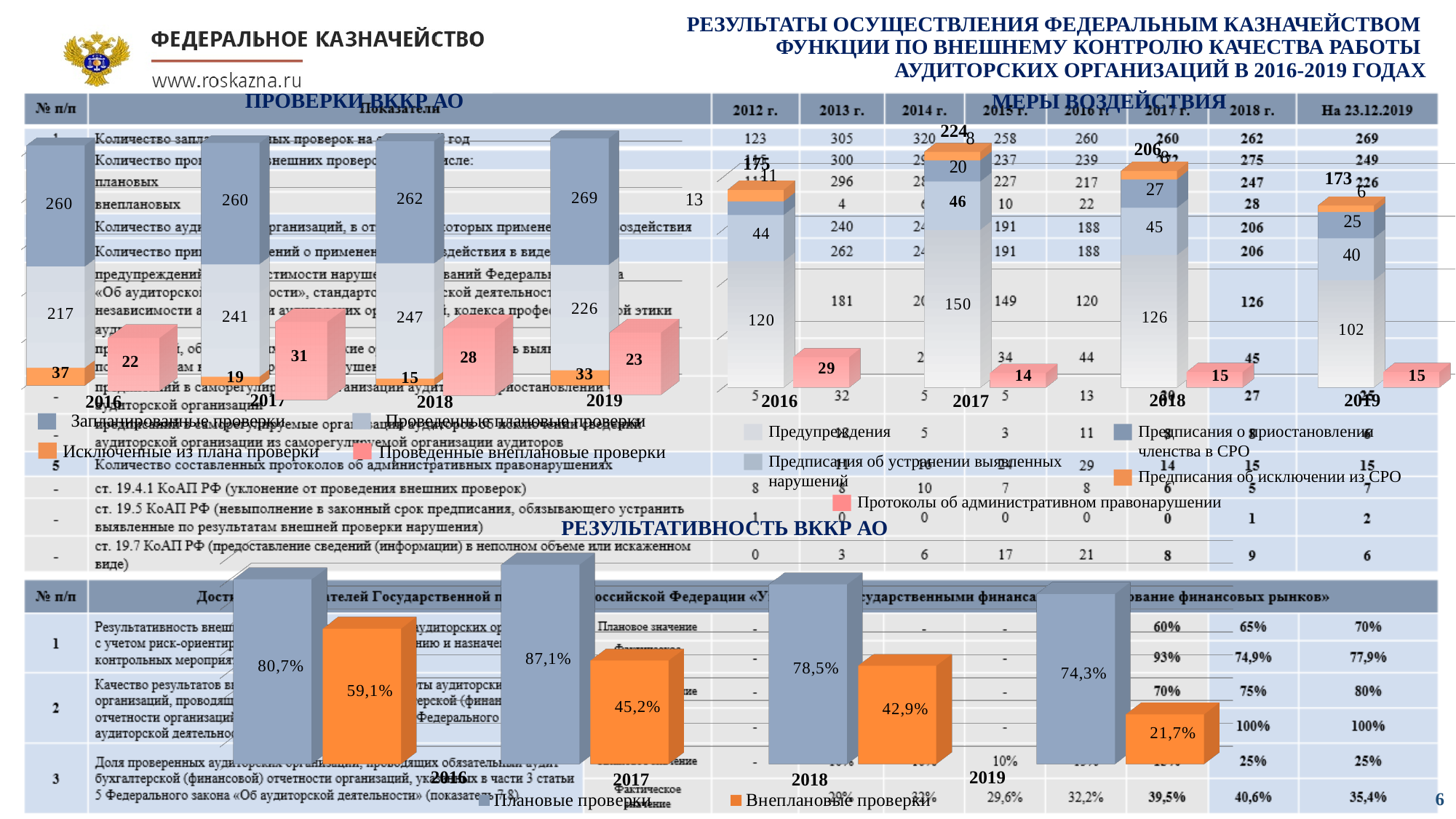
On the 'ПРОВЕРКИ ВККР АО' chart, what is the value of 'Проведенные внеплановые проверки' for 2017? 31 On the 'МЕРЫ ВОЗДЕЙСТВИЯ' chart, is the value of 'Предписания об устранении выявленных нарушений' larger in 2017 or in 2019? 2017 On the 'МЕРЫ ВОЗДЕЙСТВИЯ' chart, what is the value of 'Предупреждения' for 2017? 150 On the 'ПРОВЕРКИ ВККР АО' chart, what is the value of 'Запланированные проверки' for 2019? 269 On the 'РЕЗУЛЬТАТИВНОСТЬ ВККР АО' chart, what is the value of 'Внеплановые проверки' for 2019? 21,7% On the 'ПРОВЕРКИ ВККР АО' chart, what is the difference between 'Проведенные плановые проверки' in 2018 and in 2016? 30 On the 'РЕЗУЛЬТАТИВНОСТЬ ВККР АО' chart, do the values for 'Внеплановые проверки' rise or fall from 2016 to 2019? fall On the 'ПРОВЕРКИ ВККР АО' chart, how many series does the legend list? 4 On the 'МЕРЫ ВОЗДЕЙСТВИЯ' chart, which year has the lowest value for 'Протоколы об административном правонарушении'? 2017 On the 'ПРОВЕРКИ ВККР АО' chart, which year has the highest value for 'Исключенные из плана проверки'? 2016 On the 'РЕЗУЛЬТАТИВНОСТЬ ВККР АО' chart, which year has the highest value for 'Плановые проверки'? 2017 On the 'МЕРЫ ВОЗДЕЙСТВИЯ' chart, what is the total of the stacked bar for 2018? 206